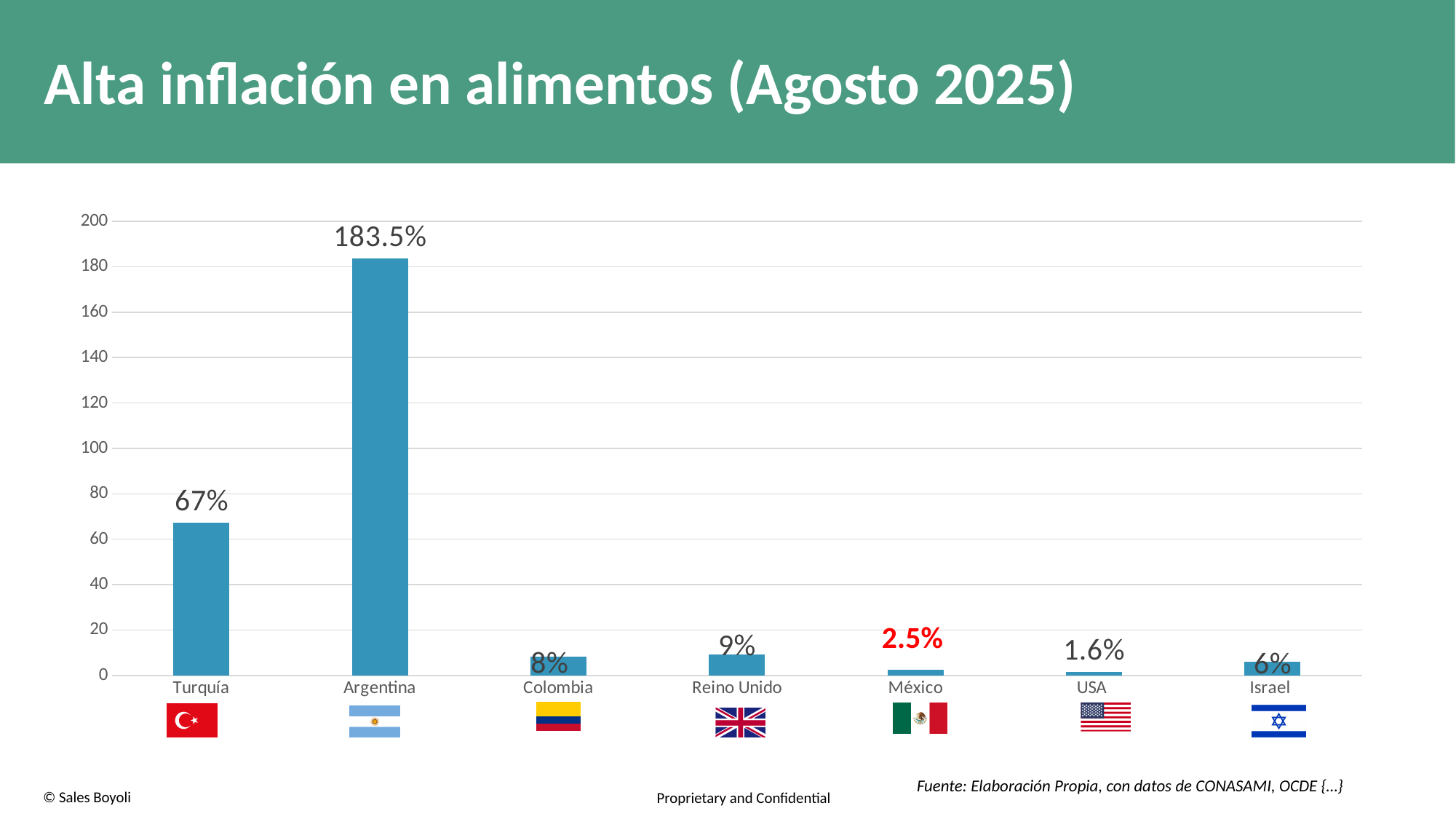
What is the value for Turquía? 67% Which country has the highest value? Argentina What kind of chart is shown on the slide? Bar chart How many countries are shown in the chart? 7 What is the value for USA? 1.6% What is the title of the slide? Alta inflación en alimentos (Agosto 2025) Which country has the lowest value? USA What is the value for México? 2.5% Is the value for Turquía greater or less than 60? greater What is the value for Argentina? 183.5% Which is larger, the value for Reino Unido or the value for Colombia? Reino Unido What is the difference between the values for Argentina and Turquía? 116.5%